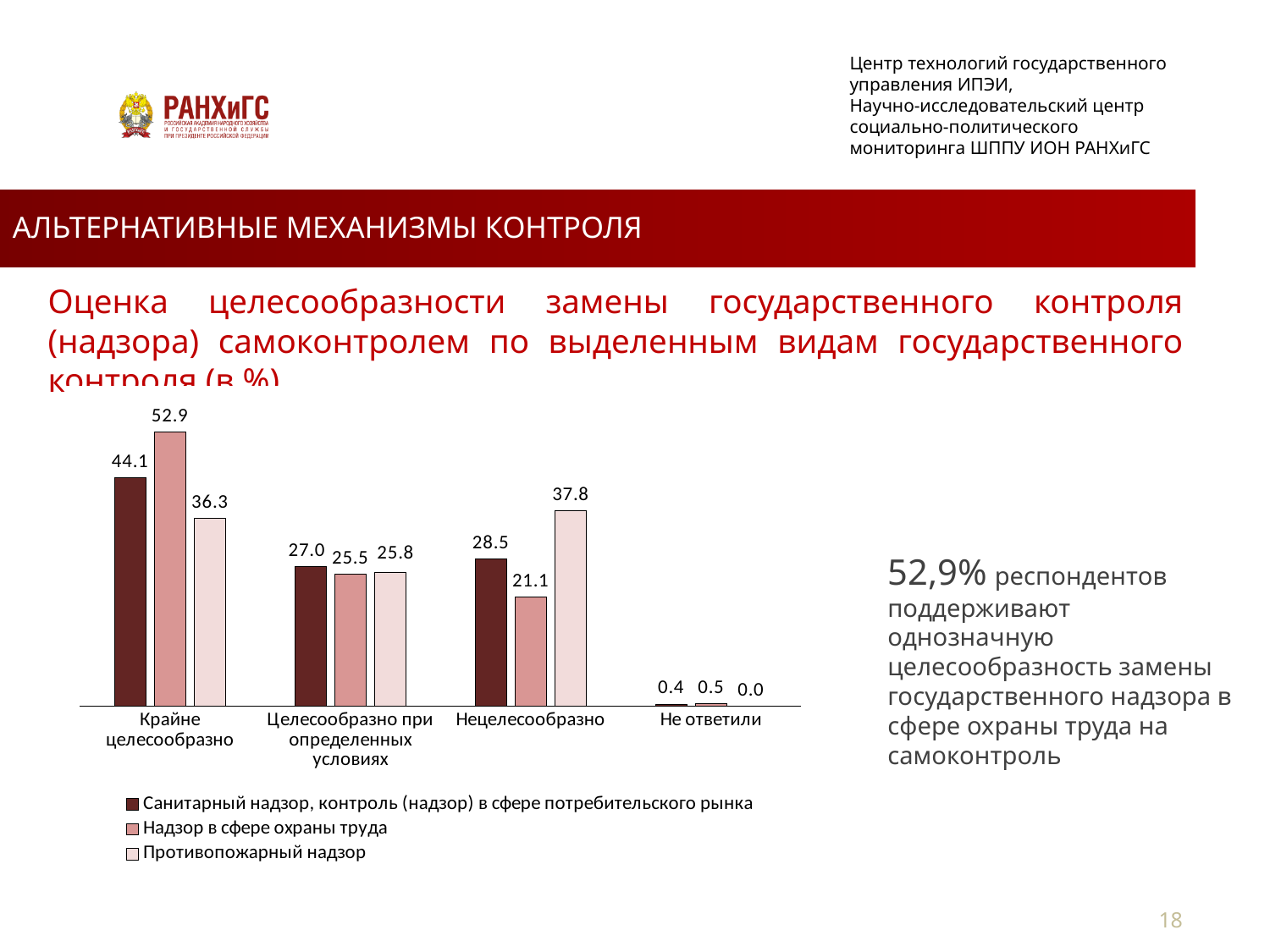
What is the difference between the «Надзор в сфере охраны труда» and «Противопожарный надзор» values in the «Крайне целесообразно» category? 16.6 What is the value for «Противопожарный надзор» in the «Нецелесообразно» category? 37.8 What is the value for «Противопожарный надзор» in the «Не ответили» category? 0.0 What kind of chart is shown on the slide? Bar chart How many categories are shown on the x axis of the chart? 4 In the «Нецелесообразно» category, which is larger: the value for «Санитарный надзор, контроль (надзор) в сфере потребительского рынка» or for «Противопожарный надзор»? Противопожарный надзор What is the value for «Надзор в сфере охраны труда» in the «Крайне целесообразно» category? 52.9 Which series has the highest value in the «Крайне целесообразно» category? Надзор в сфере охраны труда Which legend entry is shown with the darkest colour? Санитарный надзор, контроль (надзор) в сфере потребительского рынка Which series has the lowest value in the «Нецелесообразно» category? Надзор в сфере охраны труда How many series does the legend list? 3 What is the value for «Санитарный надзор, контроль (надзор) в сфере потребительского рынка» in the «Целесообразно при определенных условиях» category? 27.0